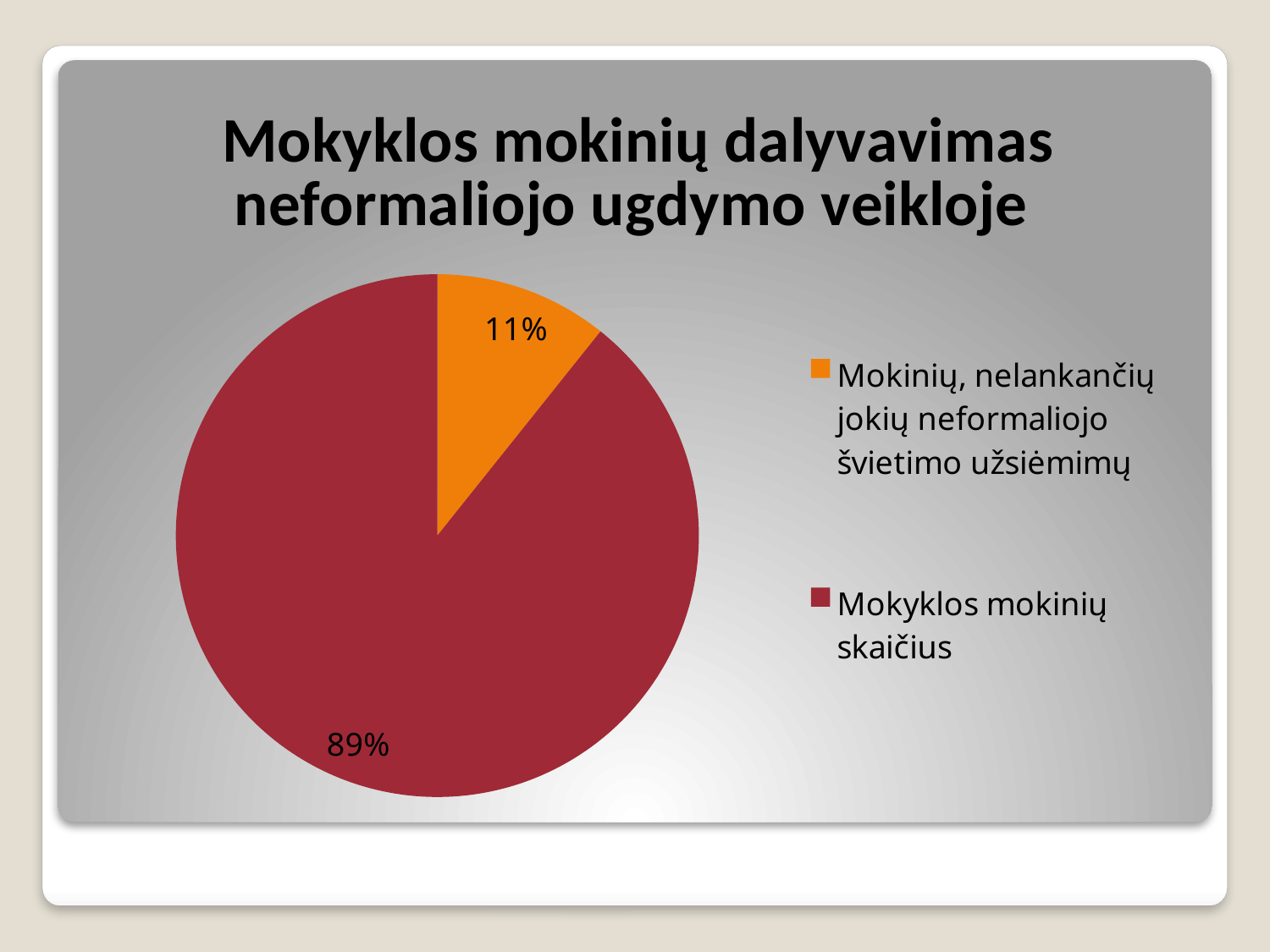
What share of the pie does "Mokyklos mokinių skaičius" represent? 89% What is the title of the slide? Mokyklos mokinių dalyvavimas neformaliojo ugdymo veikloje How many slices does the pie chart have? 2 Which slice of the pie is the largest? Mokyklos mokinių skaičius What is the difference in percentage points between the "Mokyklos mokinių skaičius" slice and the "Mokinių, nelankančių jokių neformaliojo švietimo užsiėmimų" slice? 78 percentage points Is the share for "Mokyklos mokinių skaičius" greater or less than 50%? greater Which is larger: the "Mokinių, nelankančių jokių neformaliojo švietimo užsiėmimų" slice or the "Mokyklos mokinių skaičius" slice? Mokyklos mokinių skaičius Which slice of the pie is the smallest? Mokinių, nelankančių jokių neformaliojo švietimo užsiėmimų What colour is the "Mokinių, nelankančių jokių neformaliojo švietimo užsiėmimų" slice? orange What share of the pie does "Mokinių, nelankančių jokių neformaliojo švietimo užsiėmimų" represent? 11% How many entries does the legend list? 2 What kind of chart is shown on the slide? pie chart